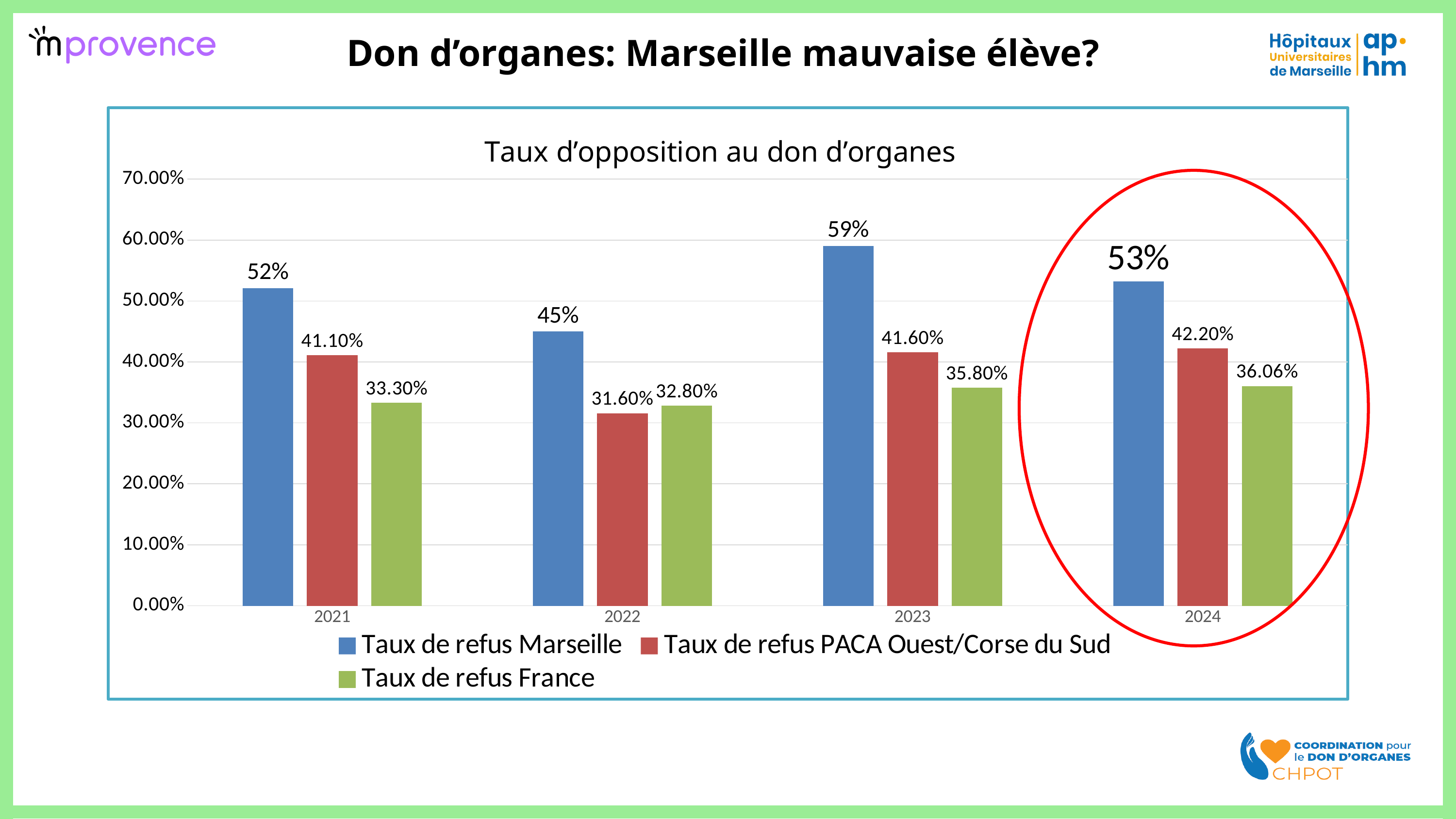
Which is larger in 2024: Taux de refus Marseille or Taux de refus PACA Ouest/Corse du Sud? Taux de refus Marseille What is the value for Taux de refus PACA Ouest/Corse du Sud in 2022? 31.60% Is the value for Taux de refus Marseille in 2022 greater or less than 40.00%? greater What is the value for Taux de refus France in 2024? 36.06% How many series does the legend list? 3 What is the title of the chart? Taux d'opposition au don d'organes What kind of chart is shown? Bar chart What is the value for Taux de refus Marseille in 2023? 59% In which year is Taux de refus Marseille highest? 2023 How many years are shown on the x axis? 4 In which year is Taux de refus France lowest? 2022